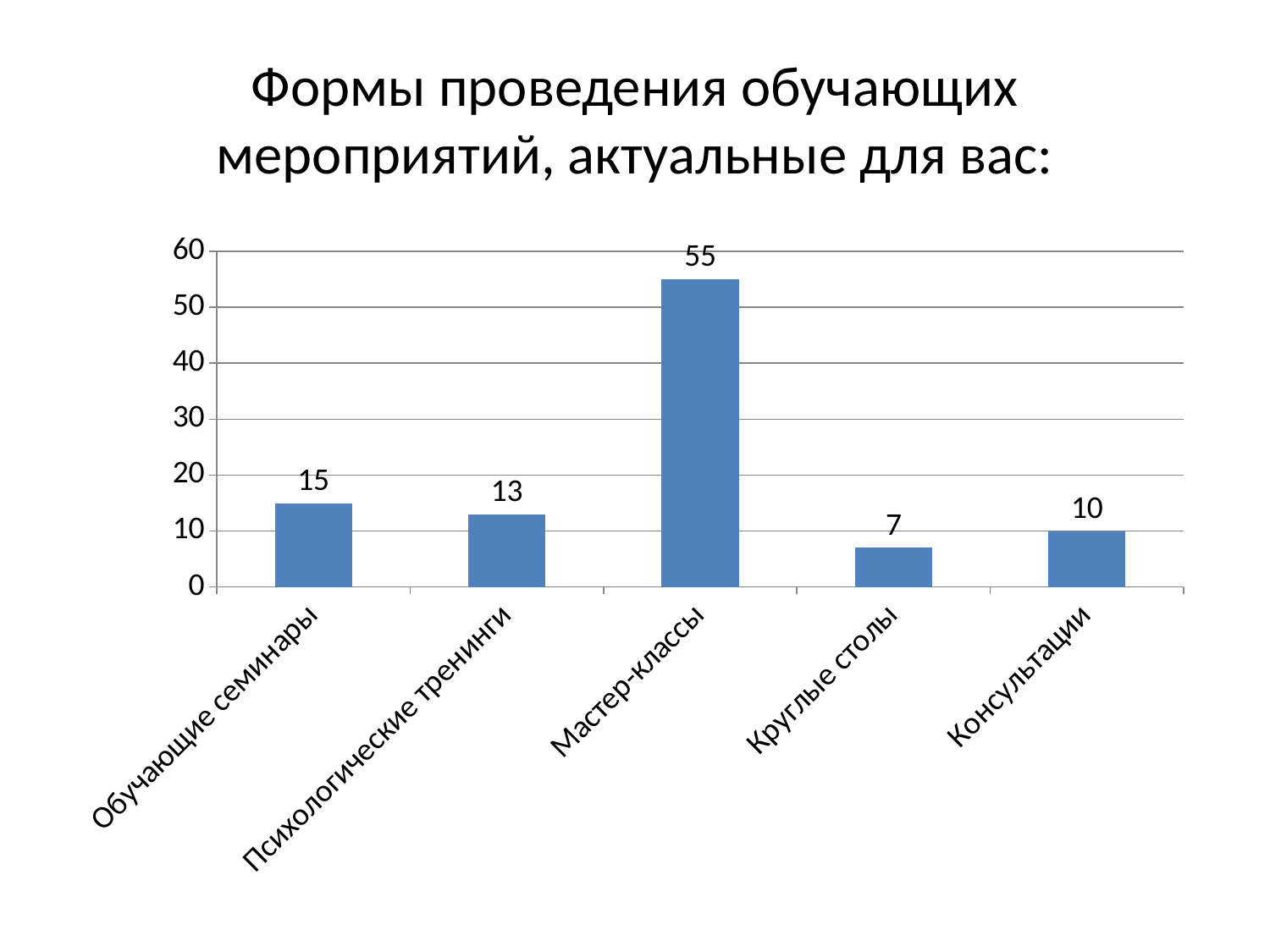
Which category has the highest value? Мастер-классы What is the difference between the values for Психологические тренинги and Консультации? 3 How many categories are shown on the chart? 5 What is the value for Мастер-классы? 55 Which category has the lowest value? Круглые столы What is the difference between the values for Мастер-классы and Обучающие семинары? 40 What is the value for Консультации? 10 What is the title of the slide? Формы проведения обучающих мероприятий, актуальные для вас: What kind of chart is shown on the slide? Bar chart What is the value for Круглые столы? 7 Which is larger, the value for Обучающие семинары or the value for Психологические тренинги? Обучающие семинары What is the value for Обучающие семинары? 15